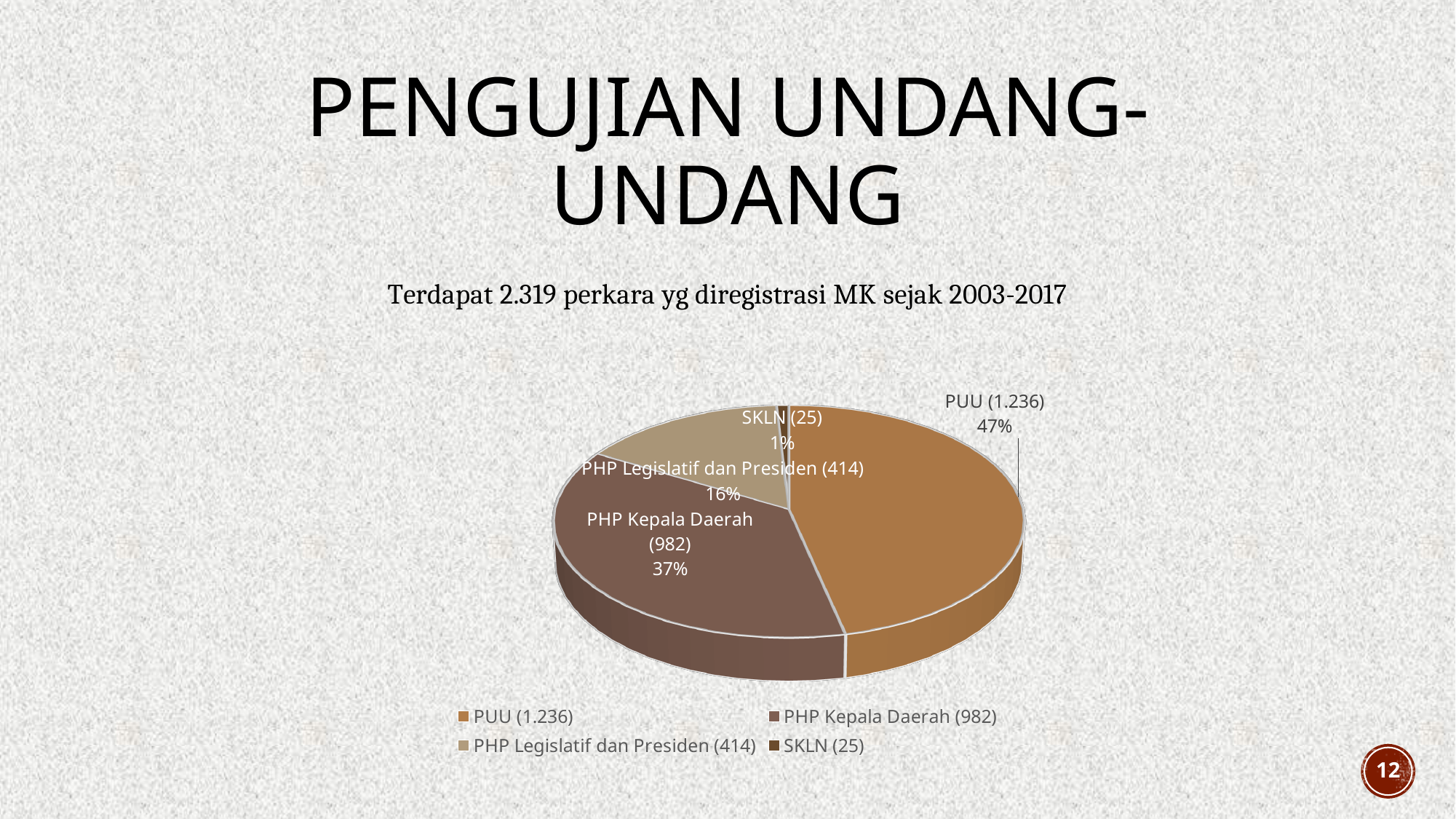
Which category has the largest slice of the pie? PUU (1.236) How many entries does the legend list? 4 Which category has the smallest slice of the pie? SKLN (25) How many categories are shown in the pie chart? 4 What percentage share of the pie does PHP Kepala Daerah (982) have? 37% What is the difference in percentage points between the PUU slice and the PHP Kepala Daerah slice? 10 According to the text above the chart, how many cases were registered at MK from 2003-2017? 2.319 What percentage share of the pie does PUU (1.236) have? 47% What type of chart is shown on the slide? Pie chart Which slice is larger: PHP Legislatif dan Presiden or SKLN? PHP Legislatif dan Presiden What percentage share of the pie does PHP Legislatif dan Presiden (414) have? 16%